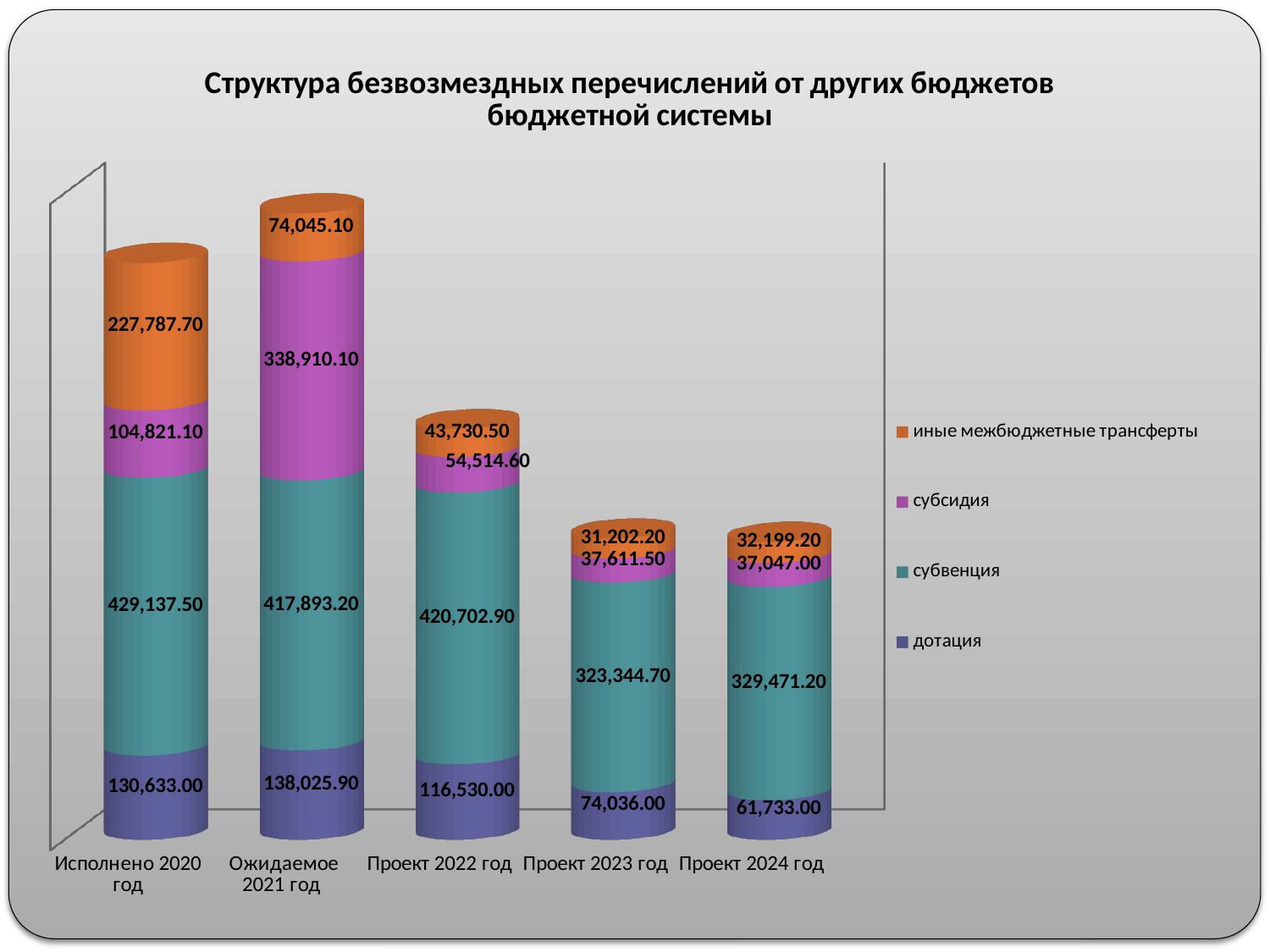
How many categories are shown on the x axis? 5 What is the value of иные межбюджетные трансферты for Исполнено 2020 год? 227,787.70 Which category has the lowest value for иные межбюджетные трансферты? Проект 2023 год How many series does the legend list? 4 What is the value of дотация for Проект 2024 год? 61,733.00 What kind of chart is shown? Stacked bar chart What is the total of the stacked bar for Проект 2023 год? 466,194.40 What is the value of субвенция for Проект 2022 год? 420,702.90 Which category has the highest value for дотация? Ожидаемое 2021 год Which is larger: субвенция for Проект 2023 год or субвенция for Проект 2024 год? Проект 2024 год What is the value of субсидия for Ожидаемое 2021 год? 338,910.10 What is the difference between the субсидия values for Ожидаемое 2021 год and Исполнено 2020 год? 234,089.00